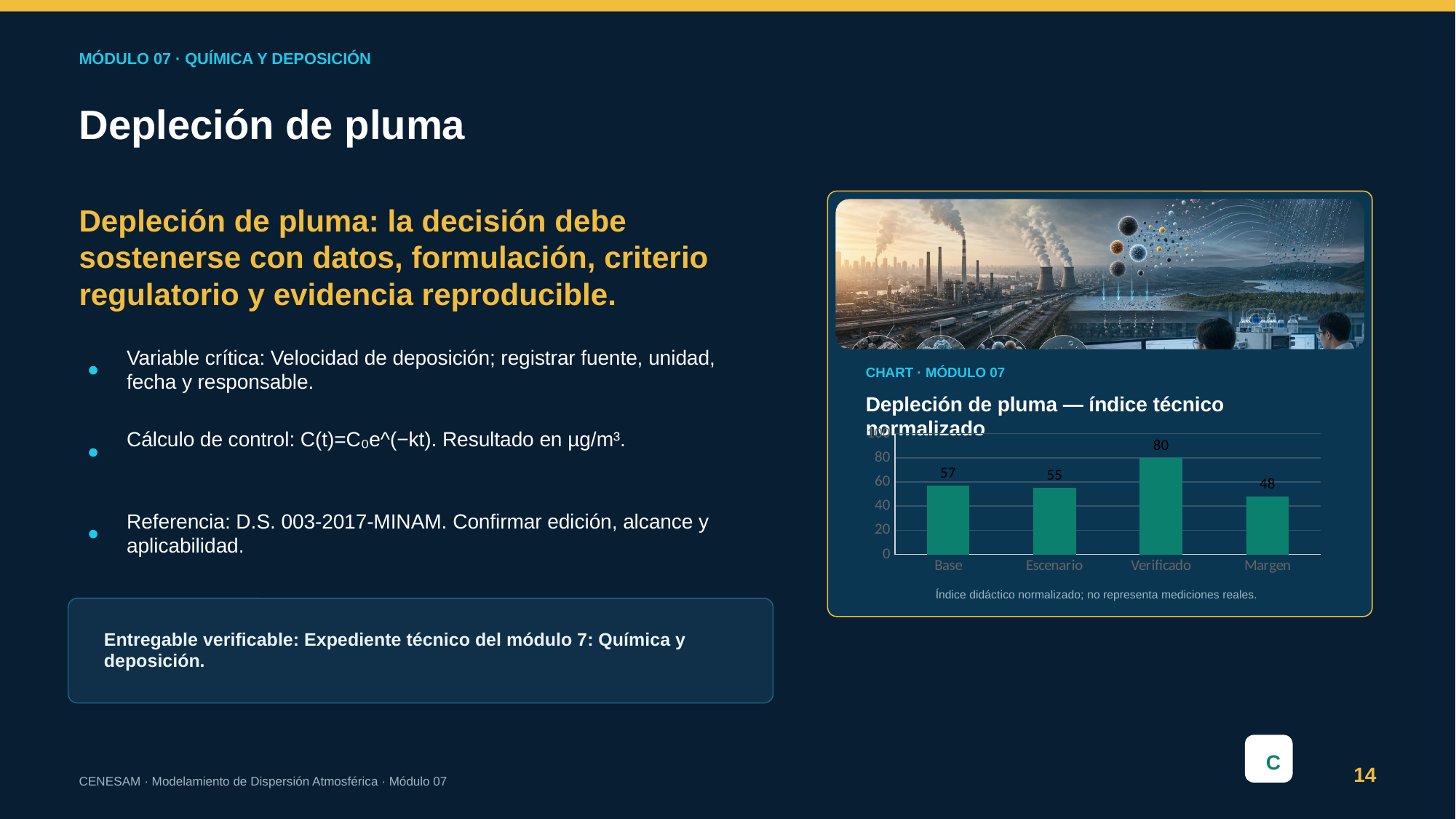
Which category has the lowest value? Margen Which is larger, the value for Base or the value for Margen? Base What is the value for Base? 57 Which category has the highest value? Verificado What is the value for Verificado? 80 What is the title of the chart? Depleción de pluma — índice técnico normalizado What is the difference between the values for Verificado and Margen? 32 What kind of chart is shown? bar chart Is the value for Verificado greater or less than 60? greater What is the value for Escenario? 55 What is the value for Margen? 48 How many categories are shown on the x axis? 4